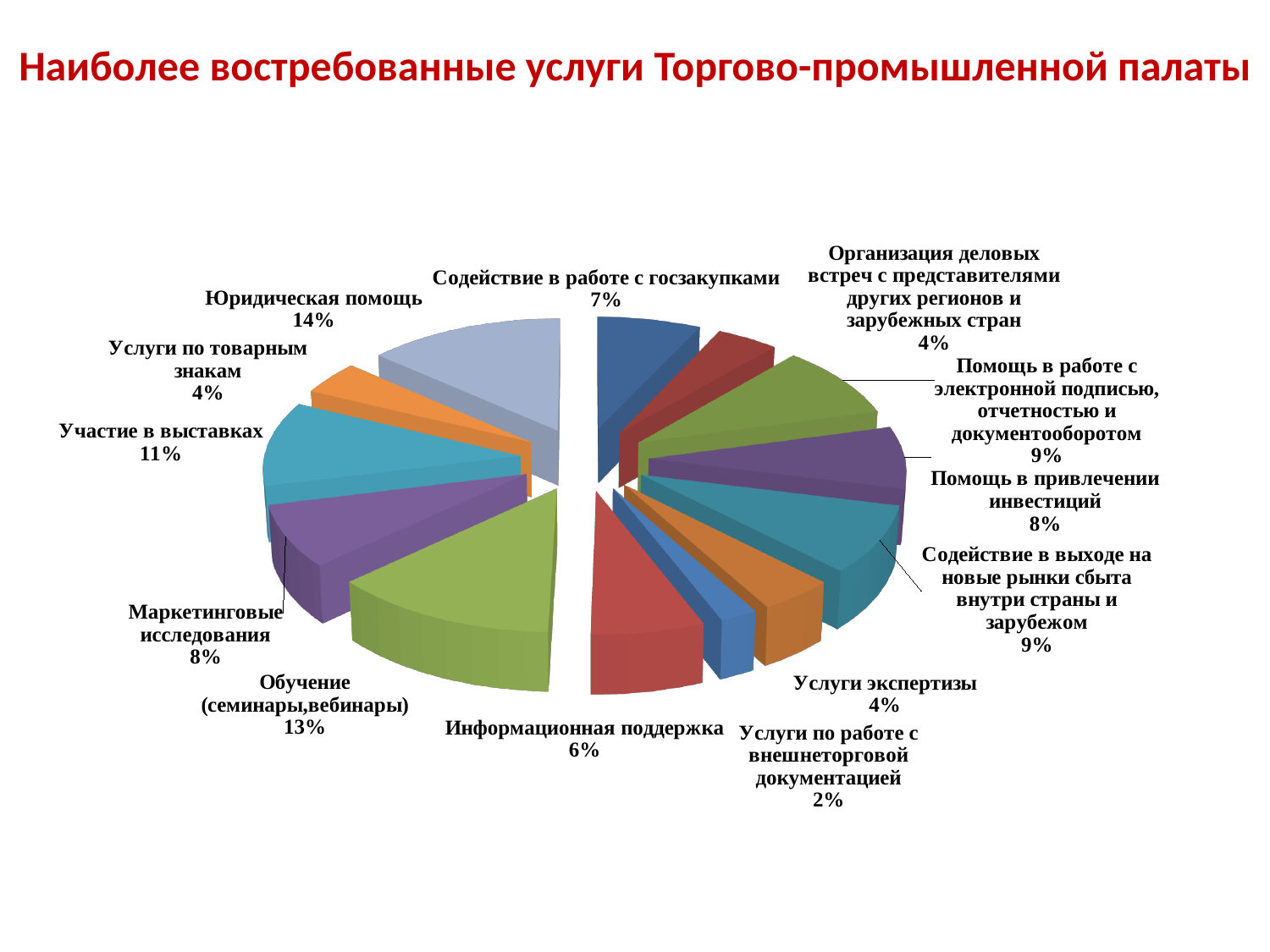
What is the difference in percentage points between Юридическая помощь and Обучение (семинары,вебинары)? 1 How many slices does the pie chart have? 13 What is the title of the slide? Наиболее востребованные услуги Торгово-промышленной палаты What share does Юридическая помощь have in the pie chart? 14% Which service has the largest share in the pie chart? Юридическая помощь What share does Информационная поддержка have? 6% What share does Участие в выставках have? 11% Which service has the smallest share in the pie chart? Услуги по работе с внешнеторговой документацией What is the difference in percentage points between Участие в выставках and Услуги экспертизы? 7 Which has a larger share: Помощь в привлечении инвестиций or Содействие в работе с госзакупками? Помощь в привлечении инвестиций What share does Обучение (семинары,вебинары) have? 13% What kind of chart is shown on the slide? pie chart